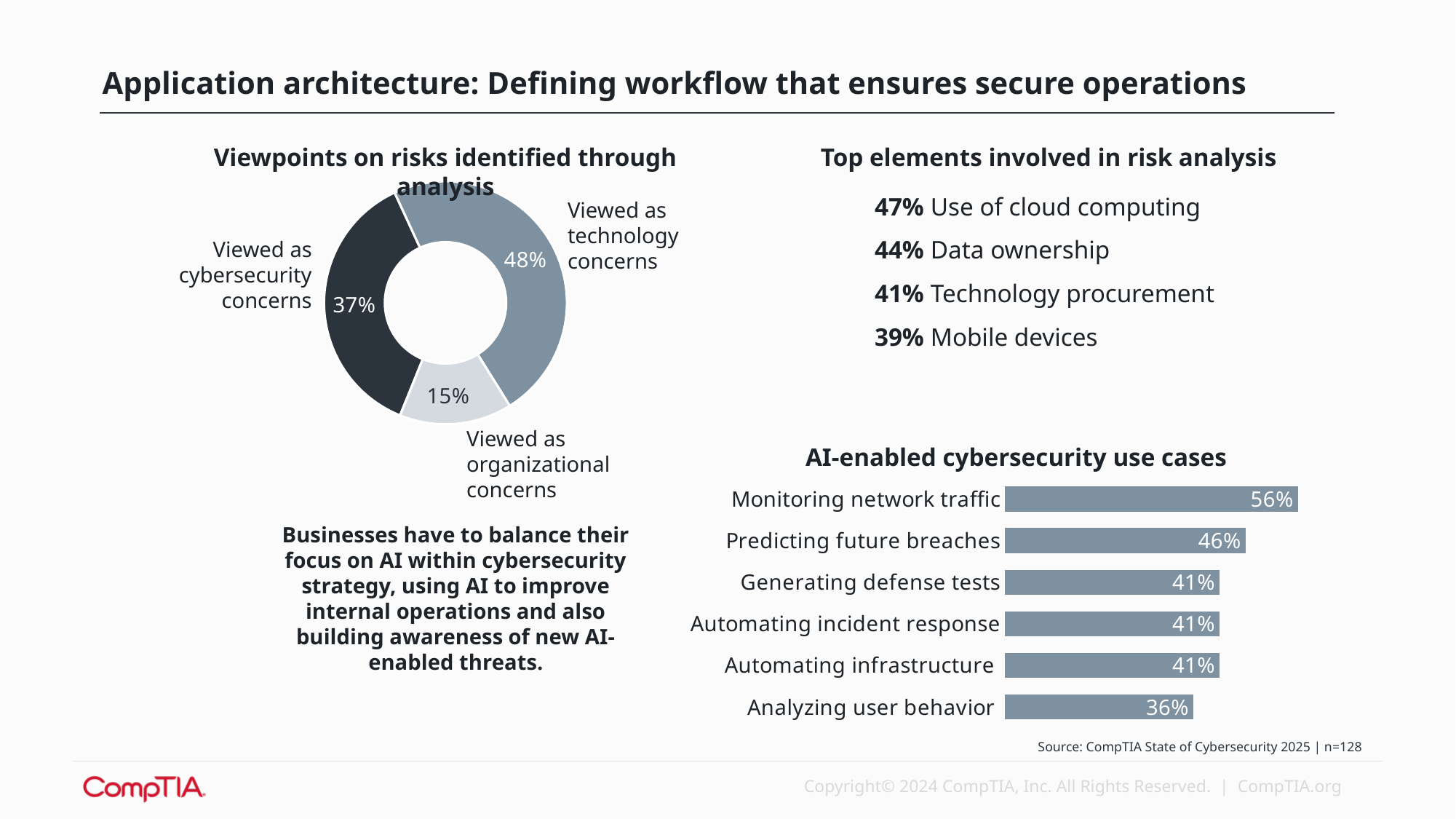
In the 'AI-enabled cybersecurity use cases' chart, what is the value for Predicting future breaches? 46% How many slices does the 'Viewpoints on risks identified through analysis' chart have? 3 In the 'AI-enabled cybersecurity use cases' chart, what is the difference between Monitoring network traffic and Analyzing user behavior? 20% What kind of chart is 'Viewpoints on risks identified through analysis'? Doughnut chart In the 'Viewpoints on risks identified through analysis' chart, what is the difference between the technology concerns share and the cybersecurity concerns share? 11% In the 'Viewpoints on risks identified through analysis' chart, which viewpoint has the smallest share? Viewed as organizational concerns In the 'AI-enabled cybersecurity use cases' chart, which use case has the highest value? Monitoring network traffic How many use cases are shown in the 'AI-enabled cybersecurity use cases' chart? 6 In the 'Viewpoints on risks identified through analysis' chart, what share of respondents viewed risks as organizational concerns? 15% In the 'AI-enabled cybersecurity use cases' chart, which use case has the lowest value? Analyzing user behavior What kind of chart is 'AI-enabled cybersecurity use cases'? Bar chart In the 'Viewpoints on risks identified through analysis' chart, what share of respondents viewed risks as technology concerns? 48%